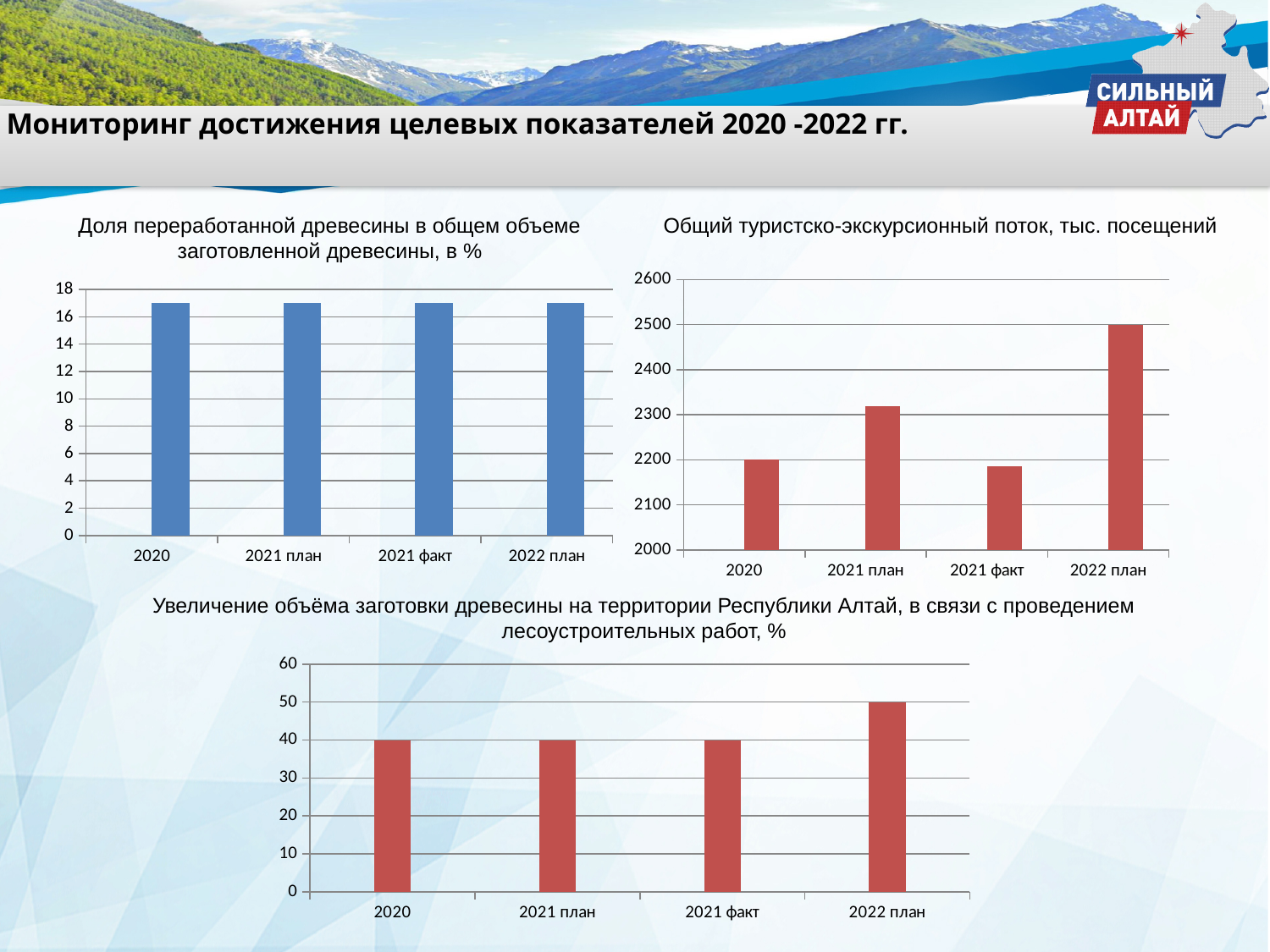
In the bottom chart 'Увеличение объёма заготовки древесины...', what is the difference between the values for 2022 план and 2021 факт? 10 In the chart 'Общий туристско-экскурсионный поток, тыс. посещений', is the value for 2021 план greater or less than 2300? greater In the chart 'Доля переработанной древесины в общем объеме заготовленной древесины, в %', is the value for 2021 факт greater or less than 16? greater In the bottom chart 'Увеличение объёма заготовки древесины...', what is the value for 2020? 40 What type of chart is the bottom chart 'Увеличение объёма заготовки древесины...'? bar chart In the bottom chart 'Увеличение объёма заготовки древесины...', what is the value for 2022 план? 50 In the chart 'Общий туристско-экскурсионный поток, тыс. посещений', what is the value for 2022 план? 2500 In the chart 'Общий туристско-экскурсионный поток, тыс. посещений', which category has the lowest value? 2021 факт In the chart 'Общий туристско-экскурсионный поток, тыс. посещений', which category has the highest value? 2022 план How many categories are shown on the x axis of the chart 'Доля переработанной древесины в общем объеме заготовленной древесины, в %'? 4 In the chart 'Общий туристско-экскурсионный поток, тыс. посещений', what is the value for 2020? 2200 In the chart 'Общий туристско-экскурсионный поток, тыс. посещений', which is larger: 2021 план or 2021 факт? 2021 план